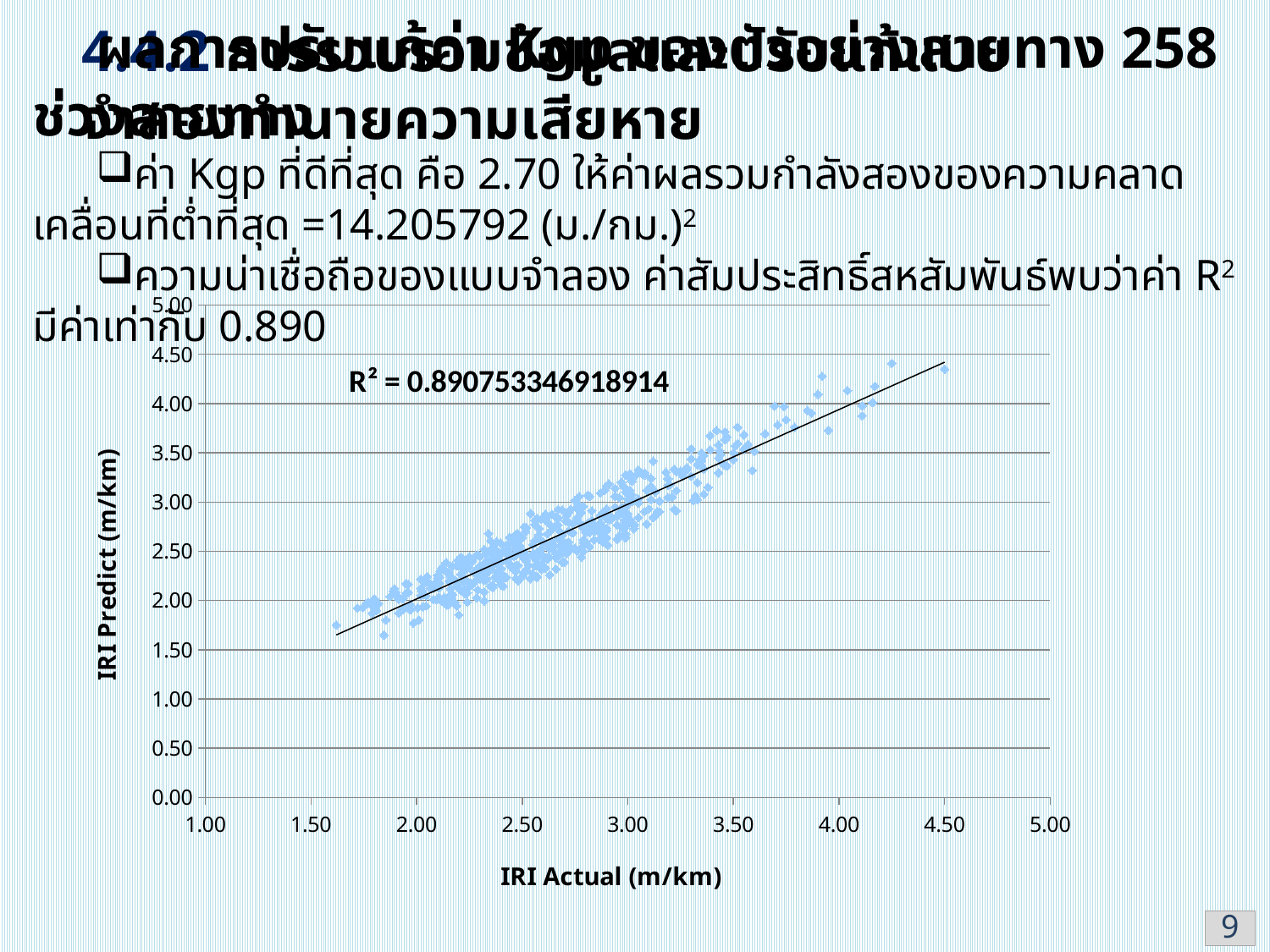
What is the maximum value shown on the x axis of the chart? 5.00 Does the chart include a fitted trendline through the scatter points? yes Do the plotted IRI Predict values rise or fall as IRI Actual increases along the x axis? rise What is the maximum value shown on the y axis of the chart? 5.00 What is the title of the y axis of the chart? IRI Predict (m/km) What is the R² value printed on the chart? R² = 0.890753346918914 What is the minimum value shown on the y axis of the chart? 0.00 What is the minimum value shown on the x axis of the chart? 1.00 What is the title of the x axis of the chart? IRI Actual (m/km) What kind of chart is shown on the slide? scatter chart